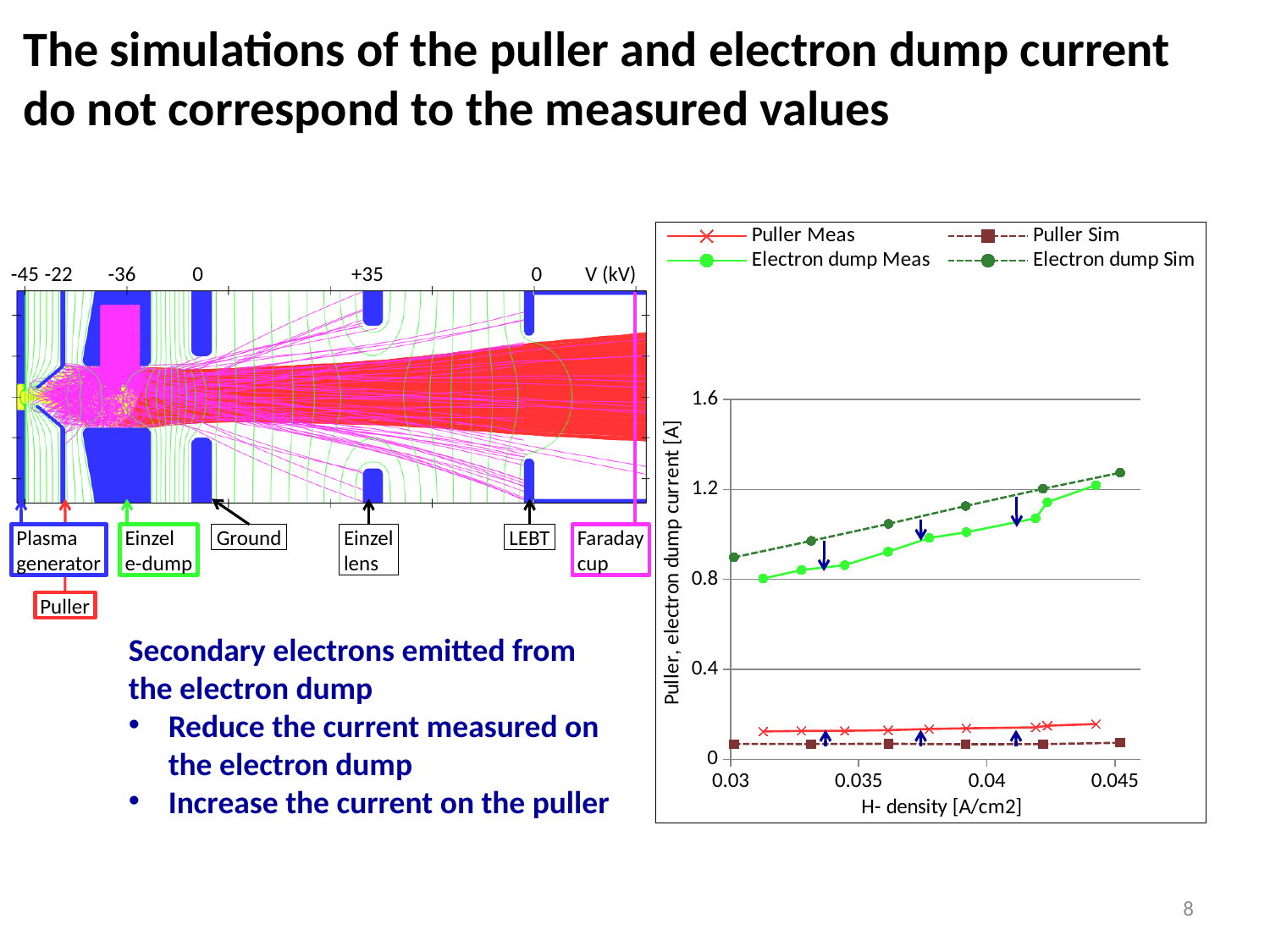
What is the x-axis title of the chart? H- density [A/cm2] What kind of chart is shown on the right of the slide? line chart Is the value of Electron dump Sim at an H- density of 0.045 A/cm2 greater or less than 1.2? greater What is the y-axis title of the chart? Puller, electron dump current [A] Is the value of Puller Meas at an H- density of 0.04 A/cm2 greater or less than 0.4? less Which is larger at an H- density of 0.04 A/cm2: Electron dump Sim or Electron dump Meas? Electron dump Sim Which series in the chart has the lowest values? Puller Sim Which is larger at an H- density of 0.035 A/cm2: Puller Meas or Puller Sim? Puller Meas Which series in the chart has the highest values? Electron dump Sim How many series does the legend of the chart list? 4 Is the value of Electron dump Meas at an H- density of 0.04 A/cm2 greater or less than 0.8? greater Does the Electron dump Meas series rise or fall as H- density increases? rises